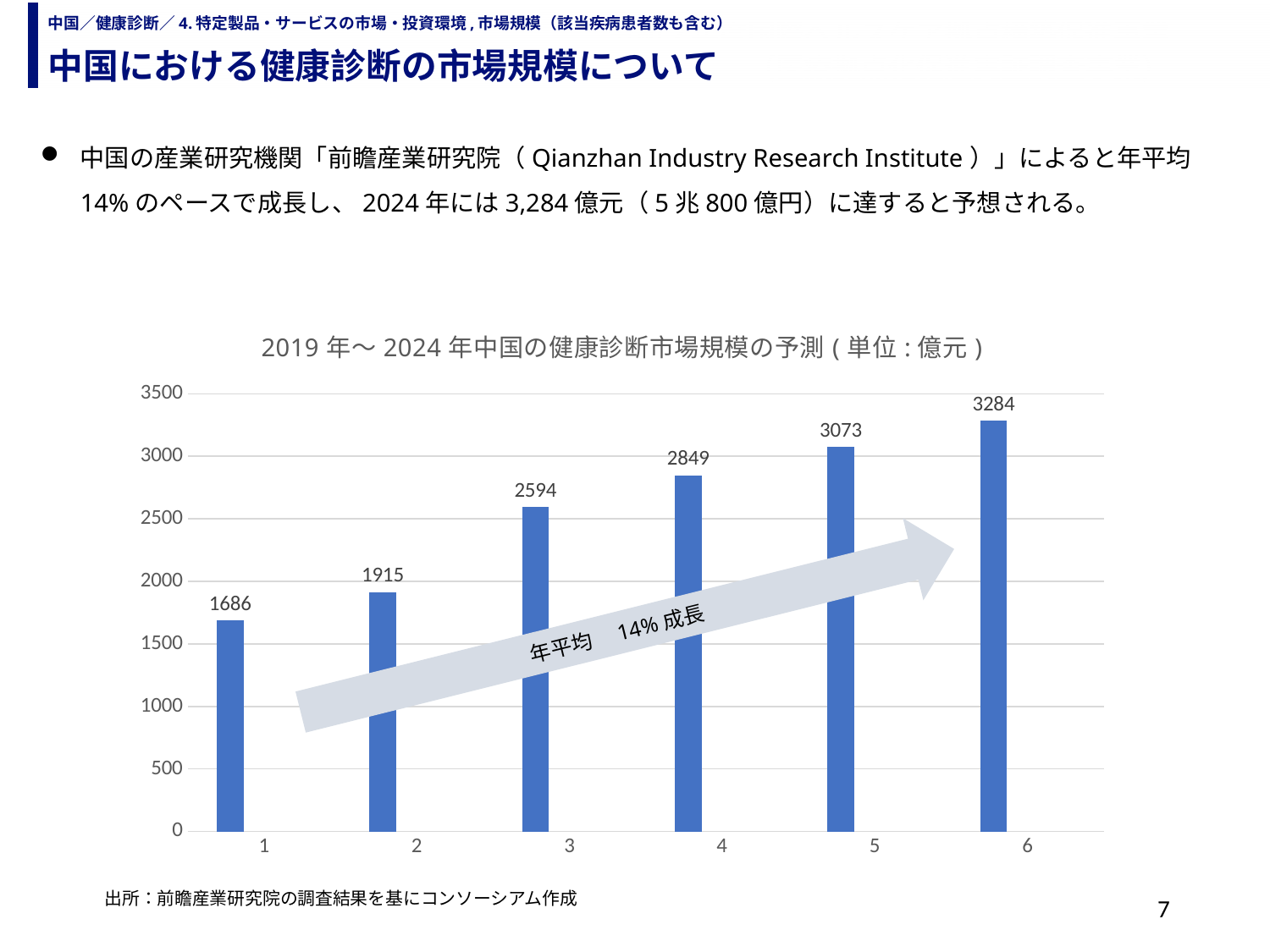
How many bars are shown in the chart? 6 Which category has the lowest value? 1 What kind of chart is shown on the slide? bar chart Do the values rise or fall from category 1 to category 6? rise Which is larger, the value for category 5 or the value for category 3? 5 Is the value for category 2 greater or less than 2000? less What is the difference between the values for category 3 and category 2? 679 Which category has the highest value? 6 What is the value for category 6? 3284 What is the value for category 4? 2849 What is the difference between the values for category 6 and category 1? 1598 What is the value for category 1? 1686